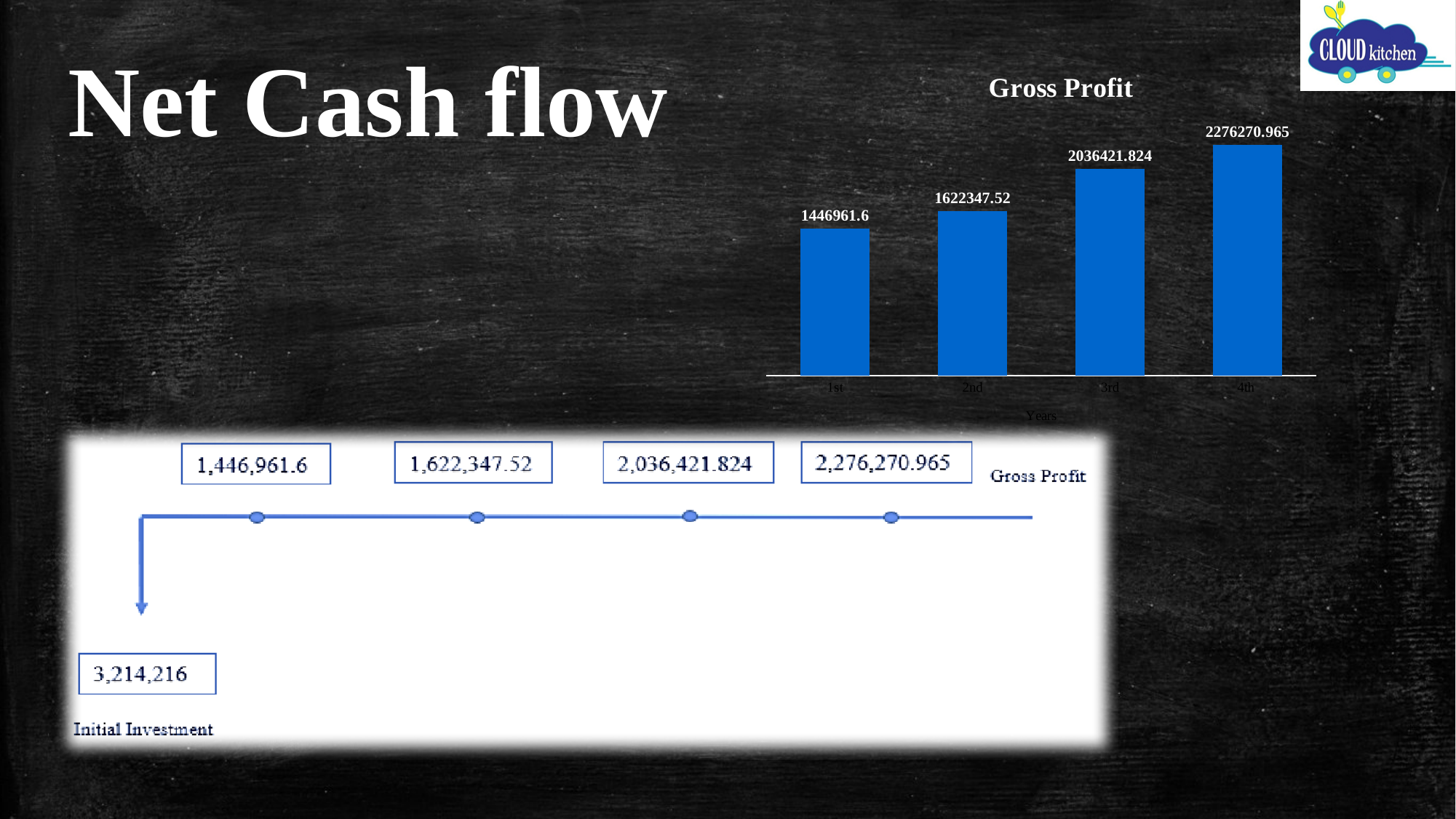
In the Gross Profit chart, what is the difference between the 2nd year and the 1st year values? 175385.92 In the Gross Profit chart, do the values rise or fall from the 1st year to the 4th year? Rise In the Gross Profit chart, which year has the lowest gross profit? 1st In the Gross Profit chart, which year has the highest gross profit? 4th In the Gross Profit chart, which is larger, the value for the 2nd year or the 3rd year? 3rd In the Gross Profit chart, what is the value for the 3rd year? 2036421.824 How many bars are shown in the Gross Profit chart? 4 In the Gross Profit chart, what is the difference between the 4th year and the 3rd year values? 239849.141 In the Gross Profit chart, what is the value for the 4th year? 2276270.965 What type of chart is the Gross Profit chart? Bar chart In the Gross Profit chart, what is the value for the 2nd year? 1622347.52 In the Gross Profit chart, what is the value for the 1st year? 1446961.6